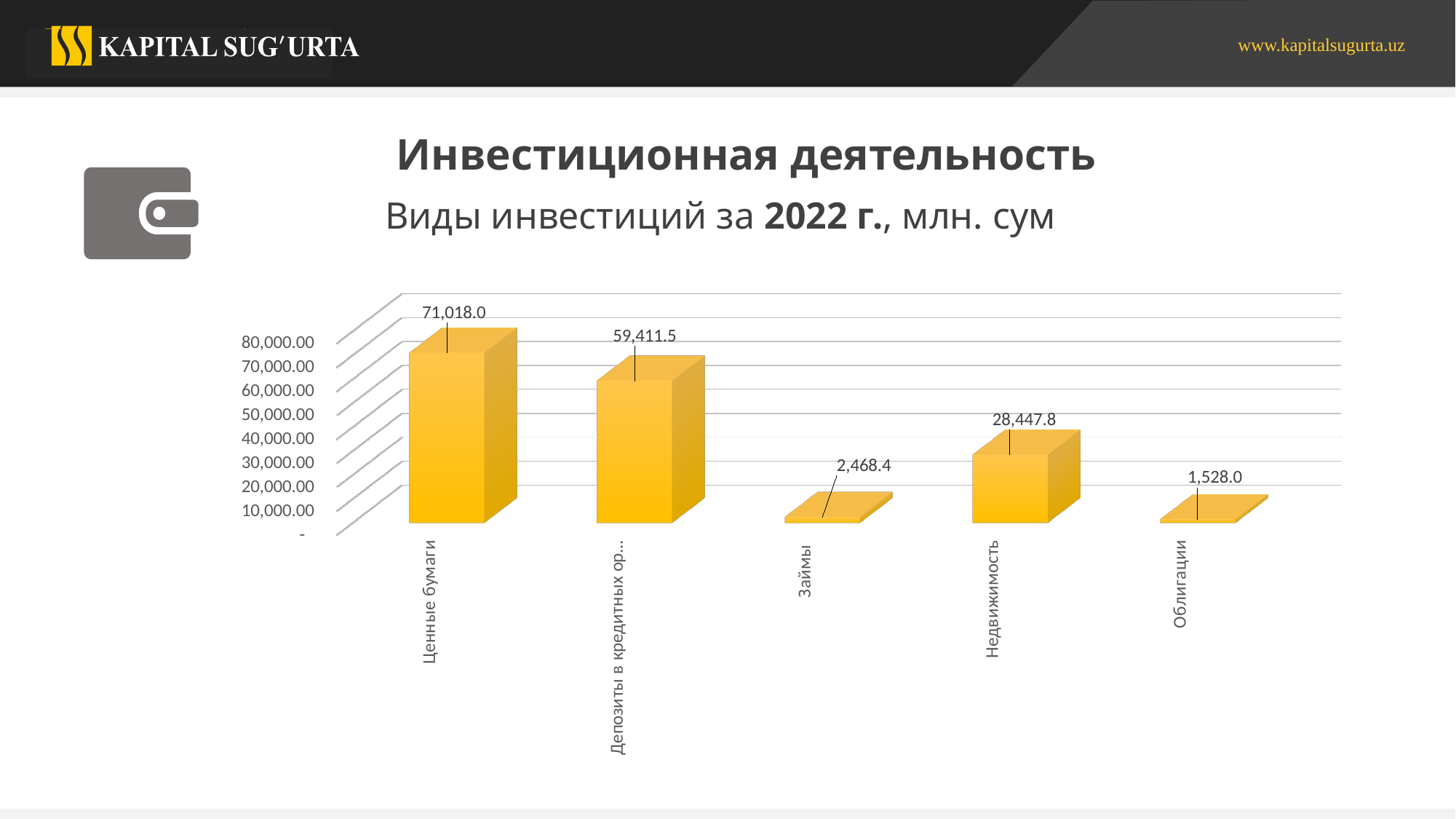
How many categories are shown in the chart? 5 Which category has the highest value? Ценные бумаги What is the value for Недвижимость? 28,447.8 What is the value for Облигации? 1,528.0 What is the value for Займы? 2,468.4 Which is larger, the value for Займы or the value for Облигации? Займы What is the subtitle of the chart on the slide? Виды инвестиций за 2022 г., млн. сум What is the difference between the values for Ценные бумаги and Недвижимость? 42,570.2 What is the value for the category labelled Депозиты в кредитных ор...? 59,411.5 Which category has the lowest value? Облигации What kind of chart is shown on the slide? Bar chart What is the value for Ценные бумаги? 71,018.0